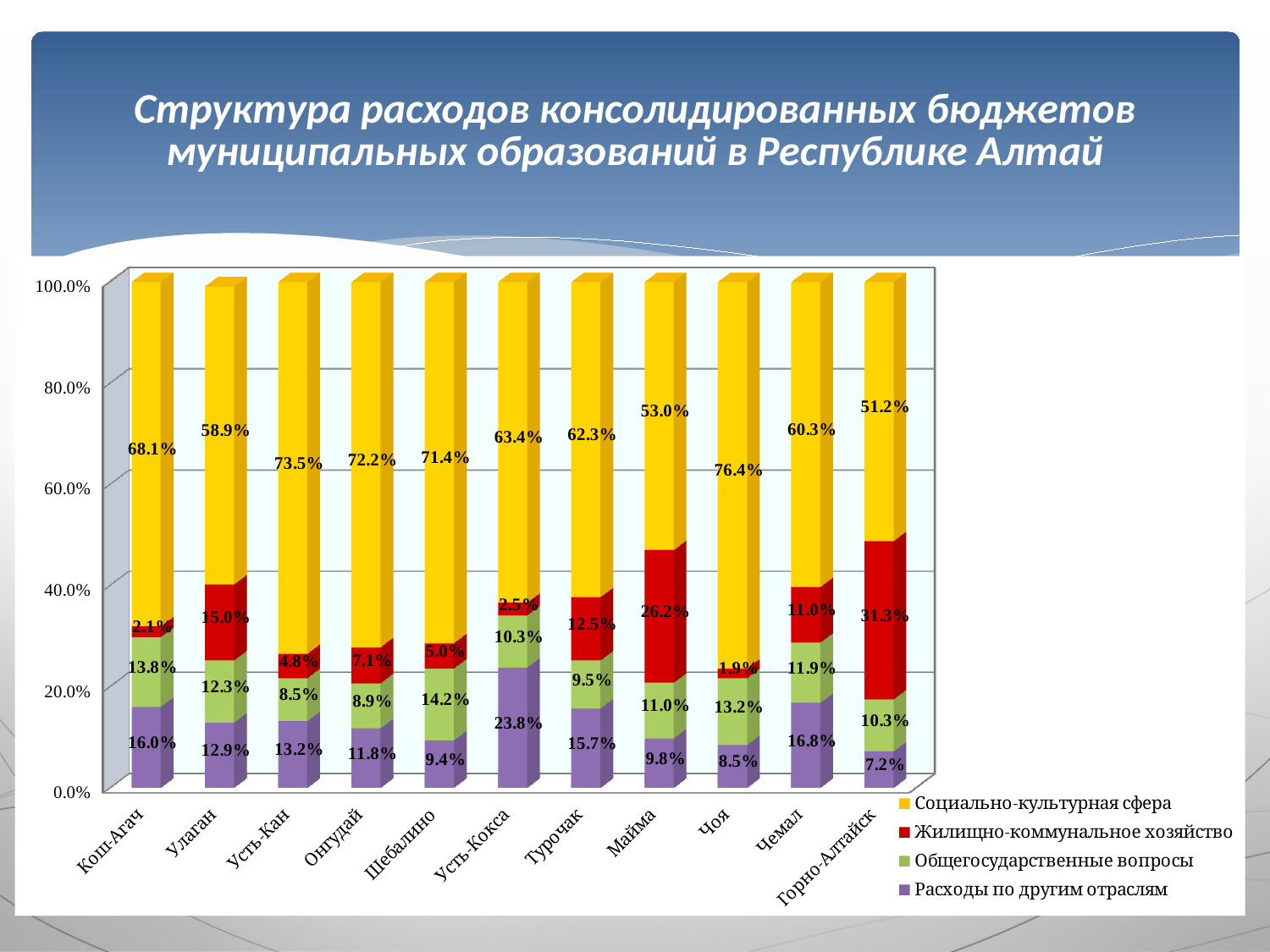
How many series does the legend list? 4 Which is larger: the Жилищно-коммунальное хозяйство value for Улаган or for Турочак? Улаган Which category has the highest value for Жилищно-коммунальное хозяйство? Горно-Алтайск Which category has the lowest value for Социально-культурная сфера? Горно-Алтайск How many categories are shown on the x axis? 11 What is the value for Социально-культурная сфера in Кош-Агач? 68.1% What is the value for Жилищно-коммунальное хозяйство in Майма? 26.2% What kind of chart is shown on the slide? Stacked bar chart What is the value for Расходы по другим отраслям in Усть-Кокса? 23.8% Which category has the highest value for Социально-культурная сфера? Чоя What is the value for Общегосударственные вопросы in Шебалино? 14.2% What is the difference between the Социально-культурная сфера values for Чоя and Горно-Алтайск? 25.2%